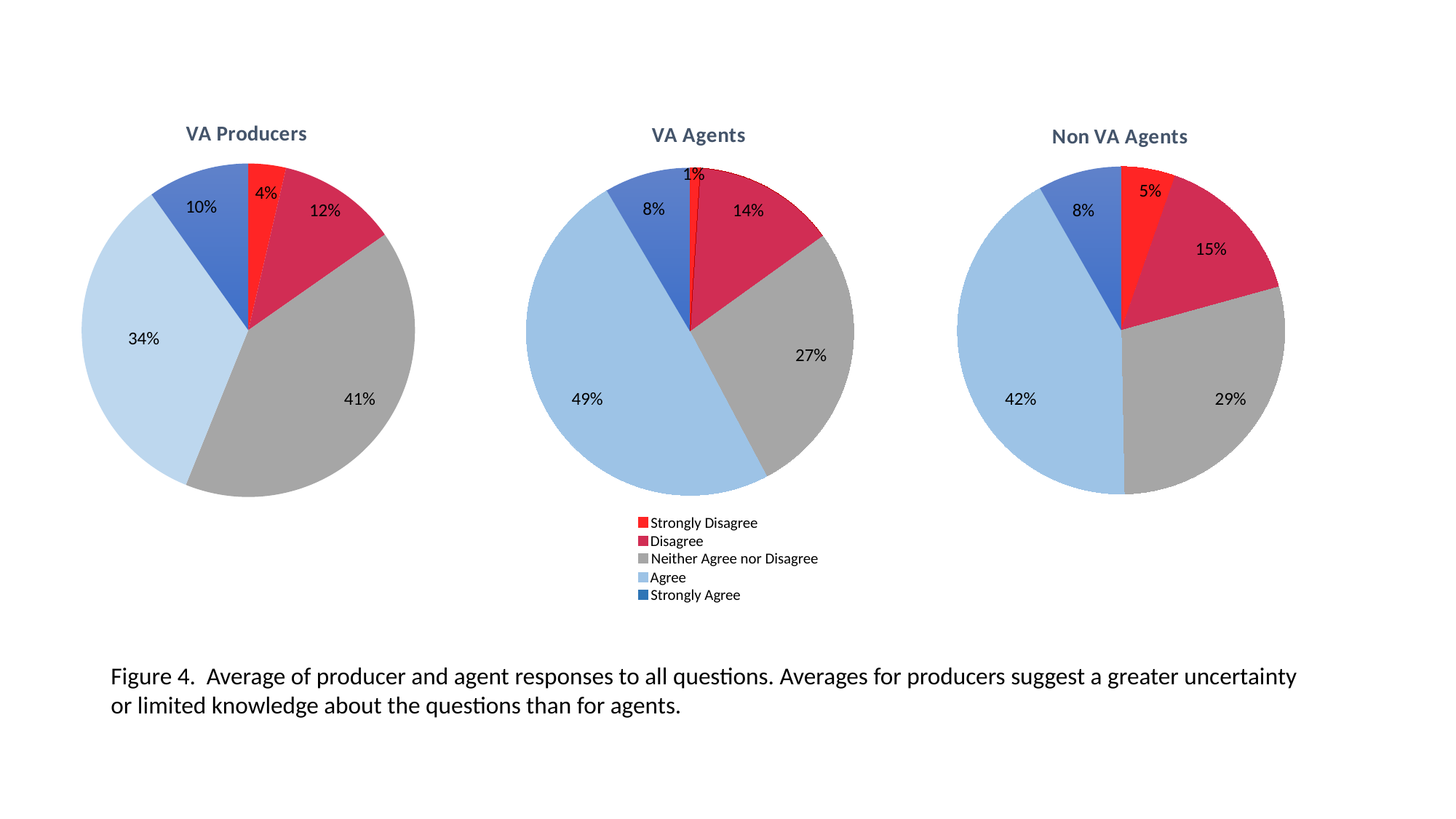
How many pie charts are shown on the slide? 3 In the Non VA Agents chart, which response category has the smallest share? Strongly Disagree In the VA Producers chart, which is larger: the Agree share or the Strongly Agree share? Agree In the VA Producers chart, what share of responses is Neither Agree nor Disagree? 41% How many response categories does the legend list? 5 In the VA Agents chart, what share of responses is Agree? 49% In the VA Agents chart, which response category has the largest share? Agree In the VA Producers chart, which response category has the largest share? Neither Agree nor Disagree What kind of chart is used for the VA Agents data? Pie chart In the VA Agents chart, what share of responses is Strongly Disagree? 1% In the Non VA Agents chart, what share of responses is Disagree? 15% In the Non VA Agents chart, what is the difference between the Agree share and the Neither Agree nor Disagree share? 13%